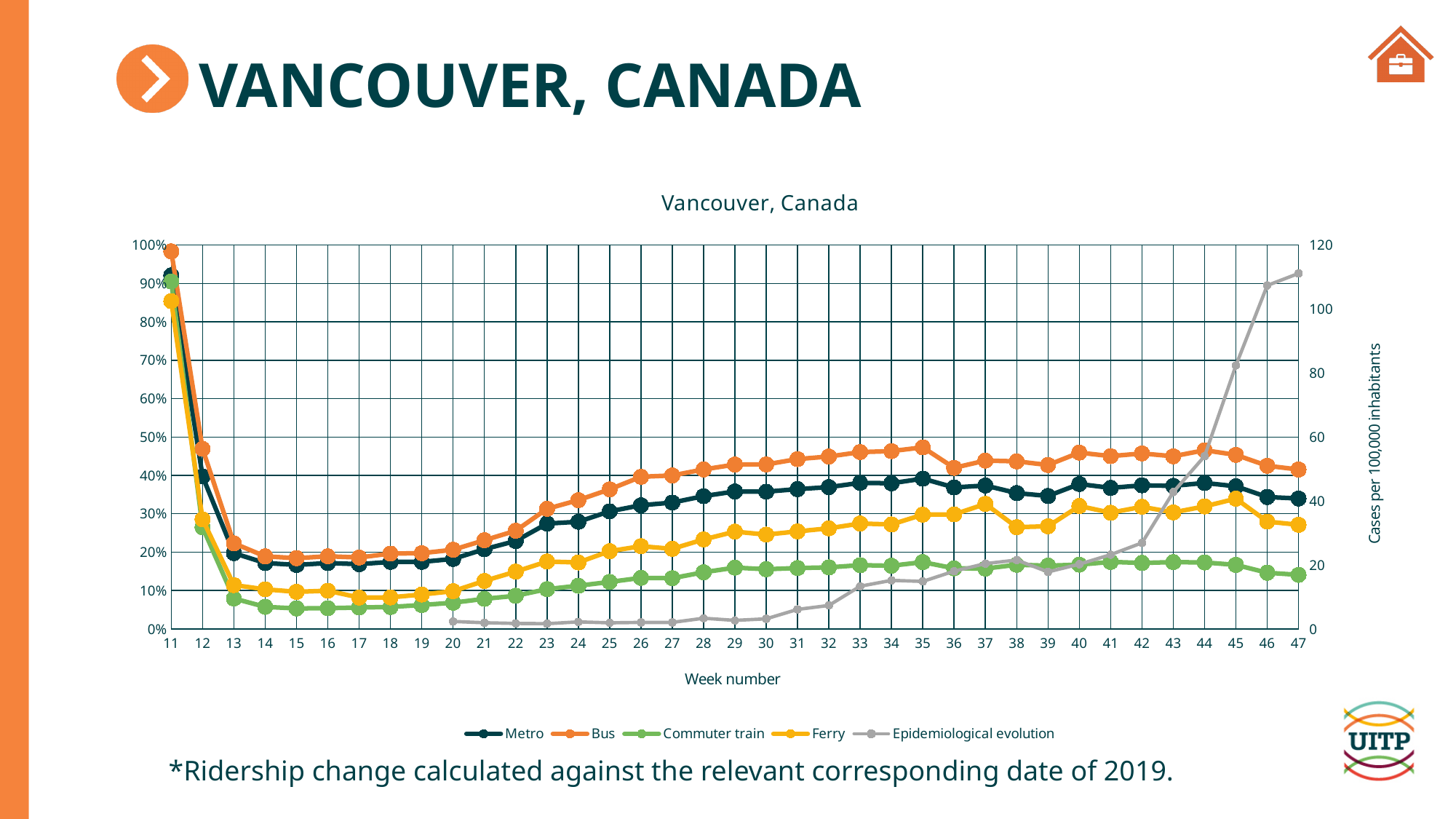
Which ridership series has the highest value at week 30? Bus Is the value for Bus at week 11 greater or less than 90%? greater What is the label of the right-hand vertical axis? Cases per 100,000 inhabitants How many series does the legend list? 5 What is the title of the chart? Vancouver, Canada What kind of chart is shown on the slide? line chart At week 35, which is larger: Bus or Metro? Bus How many week numbers are plotted along the x axis? 37 Is the value for Commuter train at week 15 greater or less than 10%? less Which ridership series has the lowest value at week 20? Commuter train Is the value for Epidemiological evolution at week 47 greater or less than 100 on the right axis? greater Does the Epidemiological evolution line rise or fall from week 40 to week 47? rise